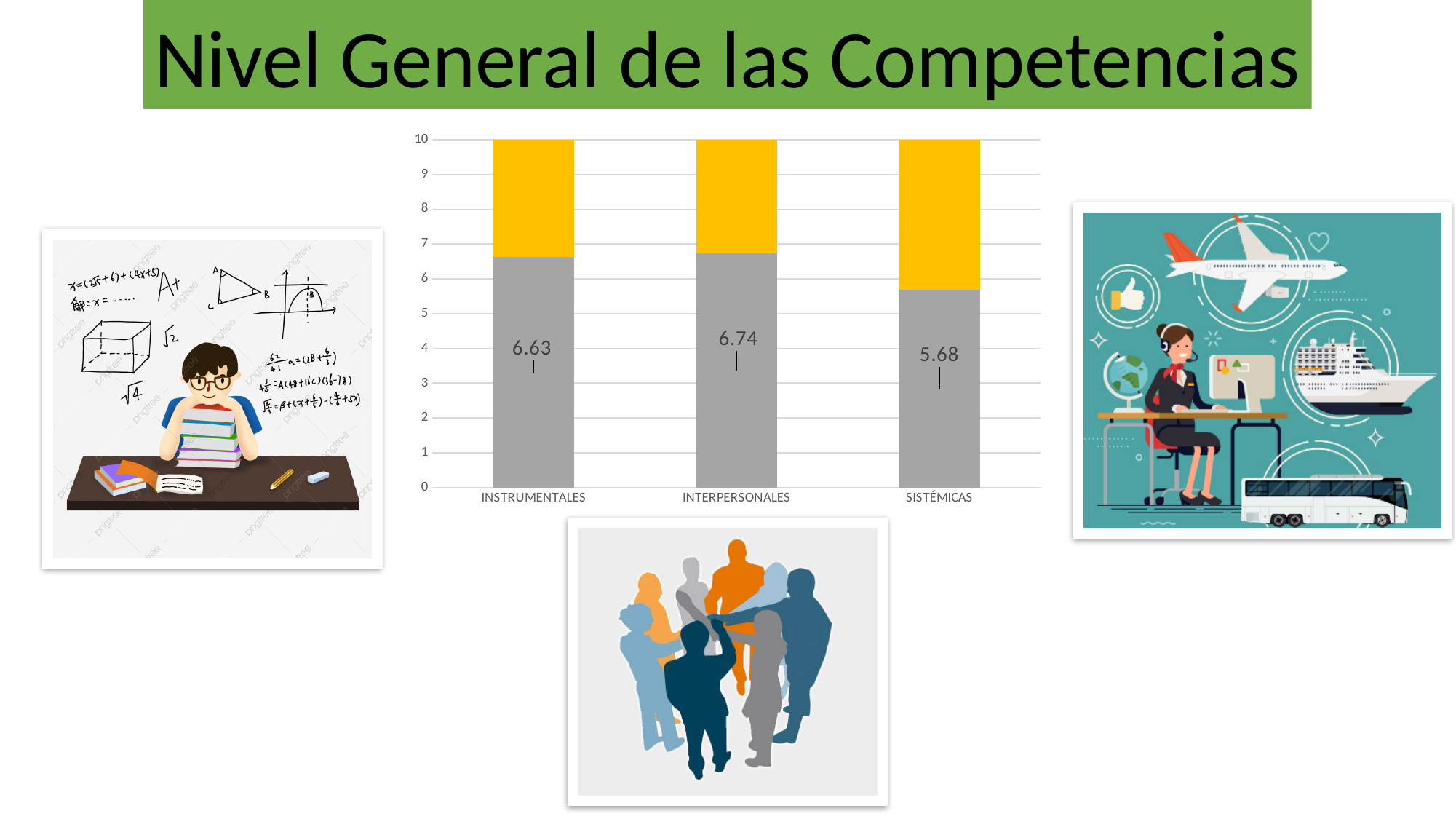
What kind of chart is shown on the slide? bar chart Which is larger, the value for INSTRUMENTALES or the value for SISTÉMICAS? INSTRUMENTALES What is the difference between the values for INTERPERSONALES and SISTÉMICAS? 1.06 Is the value for SISTÉMICAS greater or less than 6? less What is the value shown for SISTÉMICAS? 5.68 How many categories are shown on the x axis of the chart? 3 What is the value shown for INTERPERSONALES? 6.74 What is the difference between the values for INSTRUMENTALES and SISTÉMICAS? 0.95 Which category has the lowest labelled value? SISTÉMICAS What is the value shown for INSTRUMENTALES? 6.63 What is the title of the slide containing the chart? Nivel General de las Competencias Which category has the highest labelled value? INTERPERSONALES